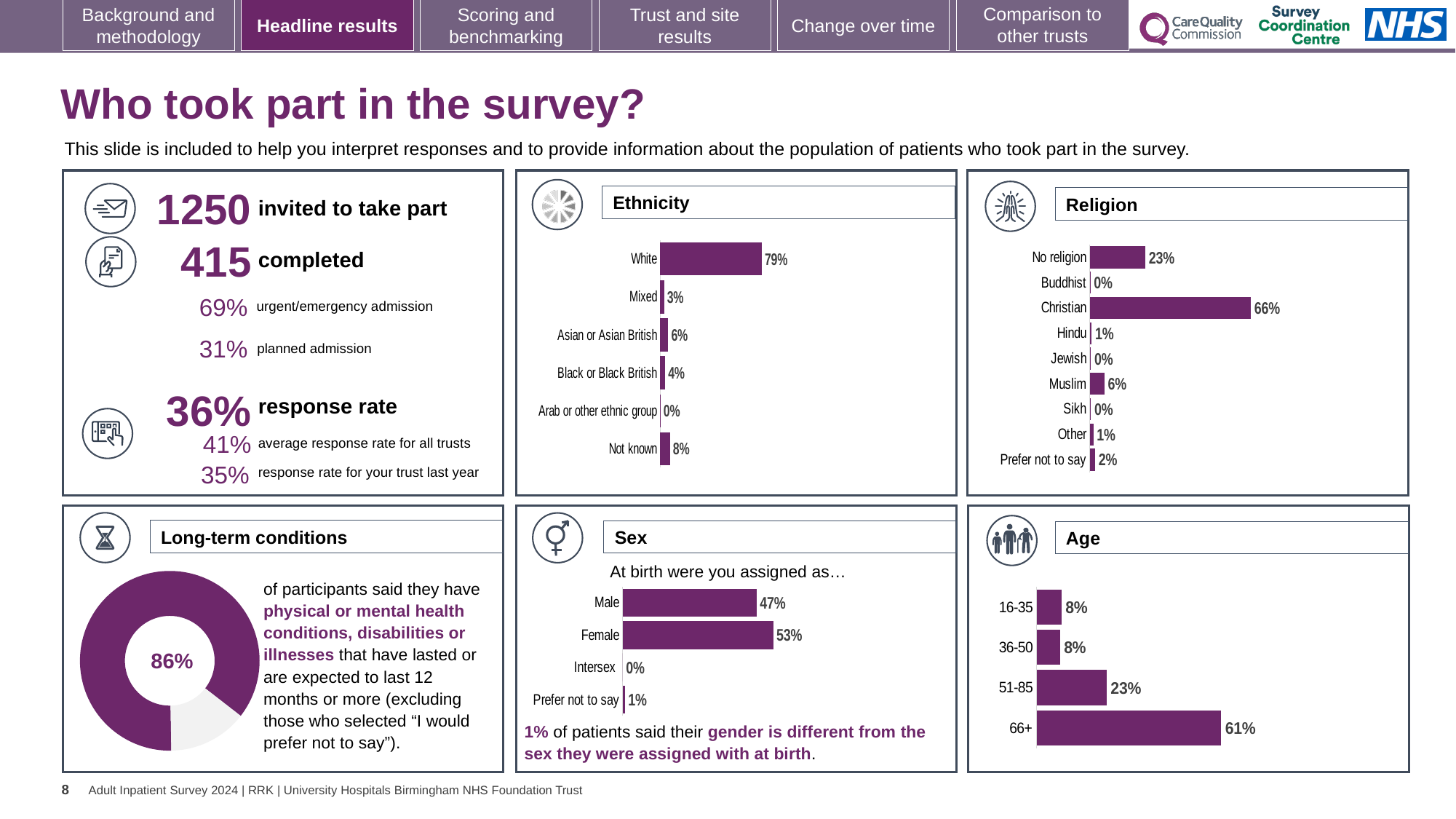
In the Ethnicity chart, which category has the highest value? White In the Ethnicity chart, how many categories are shown? 6 In the Religion chart, how many categories are shown? 9 In the Sex chart, what is the difference between Female and Male? 6% In the Religion chart, what percentage of respondents are Christian? 66% In the Age chart, what is the total of the 51-85 and 66+ groups? 84% In the Religion chart, what is the difference between Christian and No religion? 43% In the Religion chart, which is larger, Muslim or Hindu? Muslim In the Sex chart, what percentage of respondents were assigned Female at birth? 53% In the Age chart, which age group has the highest value? 66+ In the Ethnicity chart, what percentage of respondents are White? 79% What kind of chart is the Long-term conditions chart? Doughnut chart